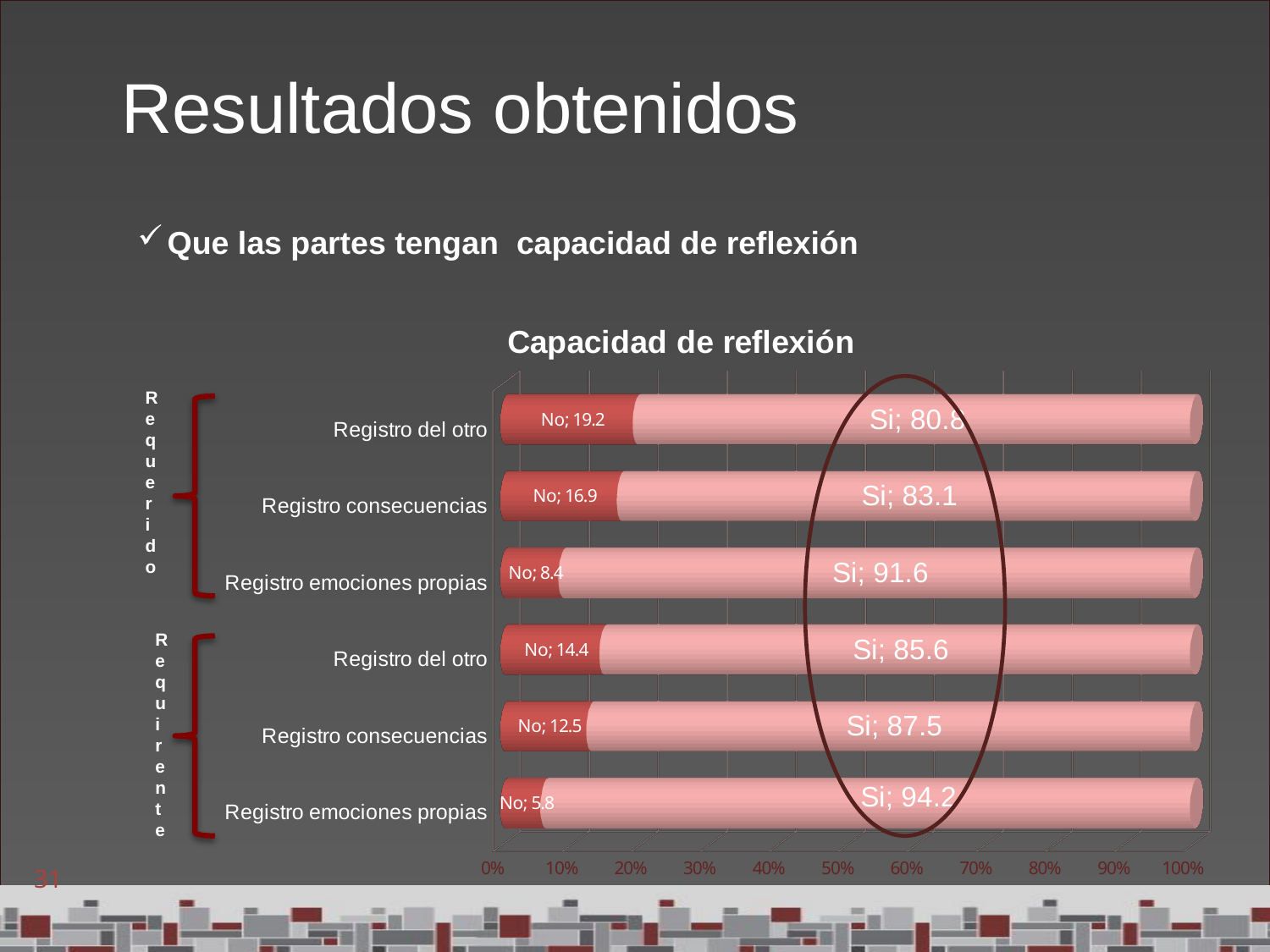
Which bar has the highest "No" value? Registro del otro (Requerido) What type of chart is shown under the title "Capacidad de reflexión"? Bar chart What is the title of the chart? Capacidad de reflexión Which bar has the lowest "No" value? Registro emociones propias (Requirente) Is the "No" value for "Registro del otro" in the "Requerido" group greater or less than 10%? greater What is the "Si" value for "Registro consecuencias" in the "Requirente" group? 87.5 What is the "No" value for "Registro consecuencias" in the "Requerido" group? 16.9 How many bars are plotted in the chart? 6 Which is larger: the "No" value for "Registro consecuencias" in the "Requerido" group or in the "Requirente" group? Requerido What is the "No" value for "Registro del otro" in the "Requirente" group? 14.4 What is the "Si" value for "Registro emociones propias" in the "Requirente" group? 94.2 What is the difference between the "Si" values for "Registro emociones propias" in the "Requerido" group and in the "Requirente" group? 2.6